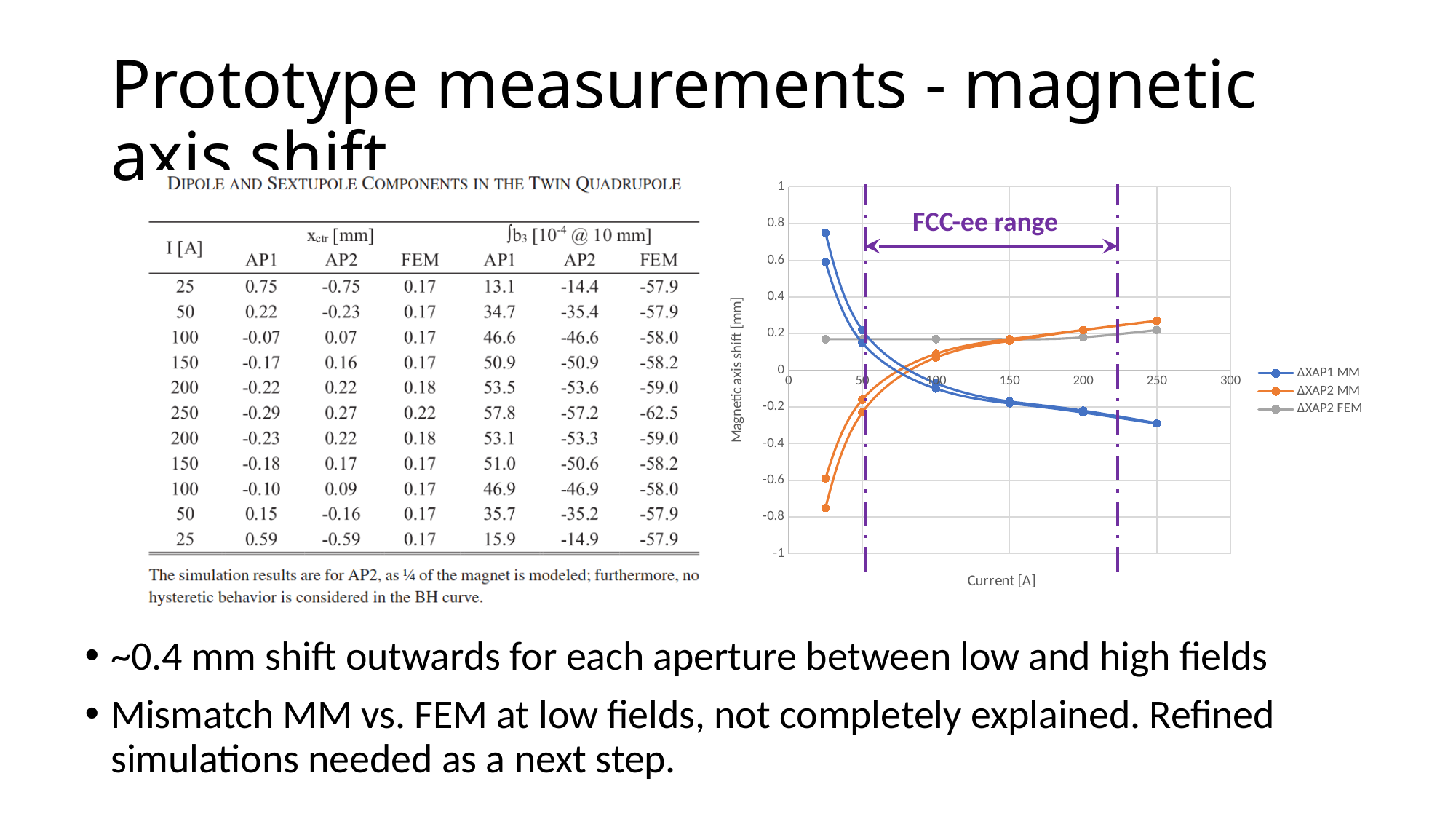
Is the value of ΔXAP2 MM at 25 A greater or less than -0.4? less How many series does the legend of the chart list? 3 Which series has the lowest value at 250 A? ΔXAP1 MM Does the ΔXAP2 MM series rise or fall as the current increases? rise Is the value of ΔXAP2 FEM at 100 A greater or less than 0.4? less Is the value of ΔXAP1 MM at 250 A greater or less than 0? less What is the label of the x axis of the chart? Current [A] At 250 A, which series has the higher value, ΔXAP1 MM or ΔXAP2 MM? ΔXAP2 MM Does the ΔXAP1 MM series rise or fall as the current increases? fall What range is marked by the purple dash-dot lines and arrow on the chart? FCC-ee range What kind of chart is shown on the right of the slide? line chart